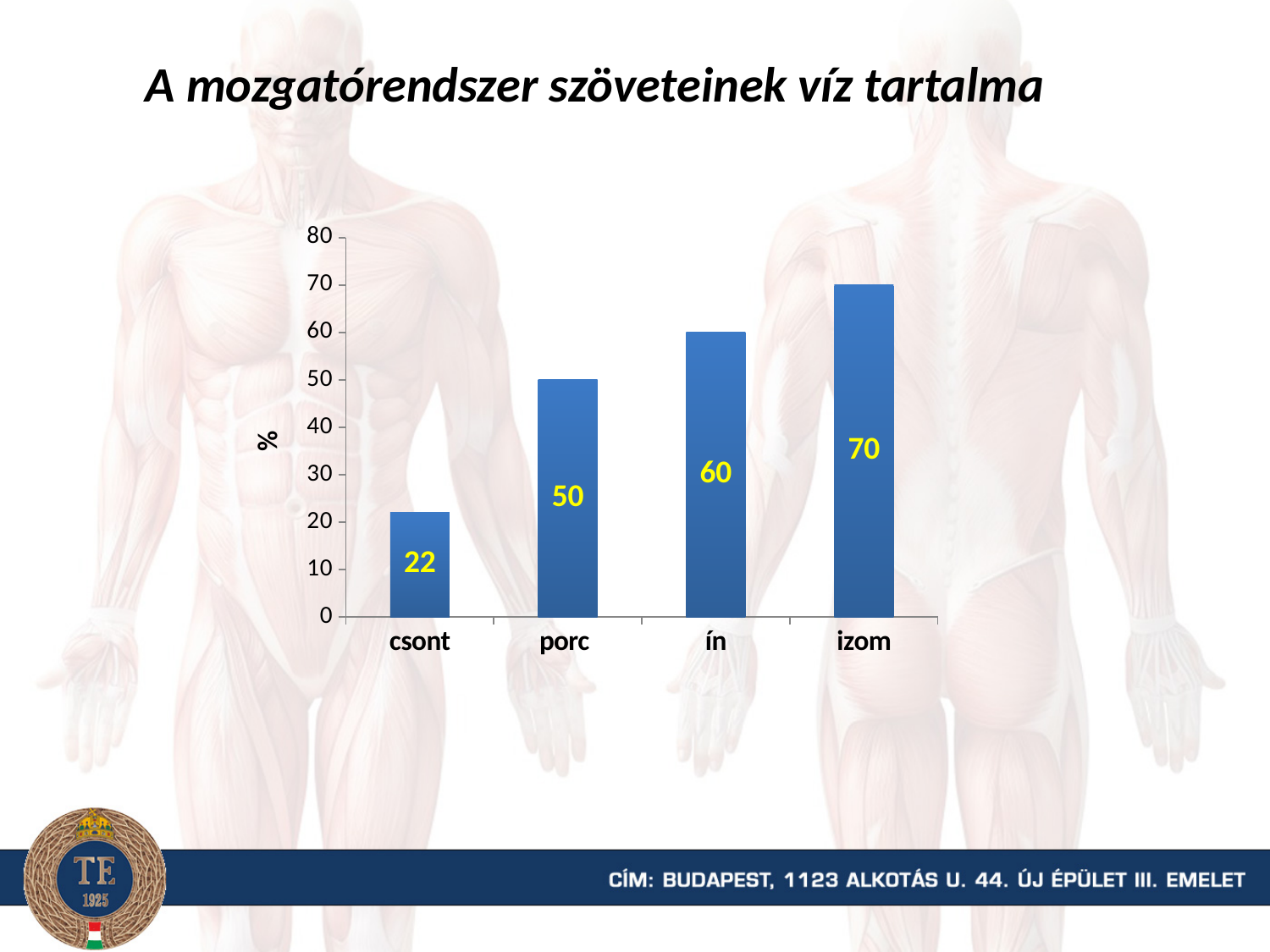
How many categories are shown on the x axis? 4 What is the label of the vertical axis? % What is the difference between the values for izom and csont? 48 Which category has the lowest value? csont Which is larger, the value for porc or the value for ín? ín What is the value for izom? 70 Is the value for csont greater or less than 30? less What kind of chart is shown on the slide? bar chart What is the value for ín? 60 What is the value for porc? 50 What is the value for csont? 22 Which category has the highest value? izom